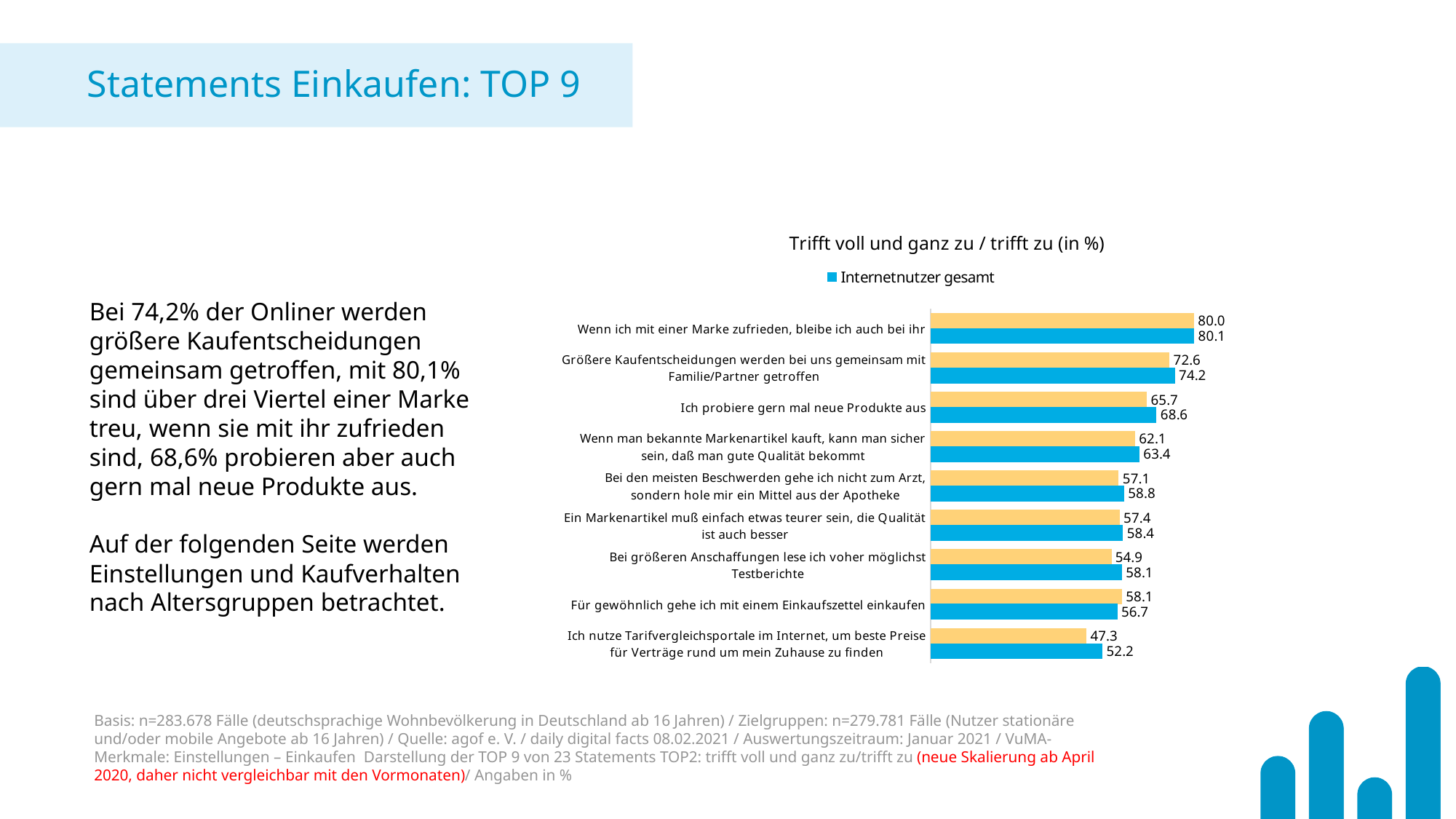
Which statement has the highest Internetnutzer gesamt value? Wenn ich mit einer Marke zufrieden, bleibe ich auch bei ihr What is the title of the chart? Trifft voll und ganz zu / trifft zu (in %) Which statement has the lowest Internetnutzer gesamt value? Ich nutze Tarifvergleichsportale im Internet, um beste Preise für Verträge rund um mein Zuhause zu finden Which has the larger Internetnutzer gesamt value: "Bei den meisten Beschwerden gehe ich nicht zum Arzt, sondern hole mir ein Mittel aus der Apotheke" or "Bei größeren Anschaffungen lese ich voher möglichst Testberichte"? Bei den meisten Beschwerden gehe ich nicht zum Arzt, sondern hole mir ein Mittel aus der Apotheke What kind of chart is shown on the slide? Bar chart How many statements are shown in the chart? 9 What is the Internetnutzer gesamt value for "Ich probiere gern mal neue Produkte aus"? 68.6 How many series does the legend list? 1 What is the difference between the highest and lowest Internetnutzer gesamt values? 27.9 What value is shown on the yellow bar for "Ich nutze Tarifvergleichsportale im Internet, um beste Preise für Verträge rund um mein Zuhause zu finden"? 47.3 What is the Internetnutzer gesamt value for "Größere Kaufentscheidungen werden bei uns gemeinsam mit Familie/Partner getroffen"? 74.2 What is the Internetnutzer gesamt value for "Für gewöhnlich gehe ich mit einem Einkaufszettel einkaufen"? 56.7